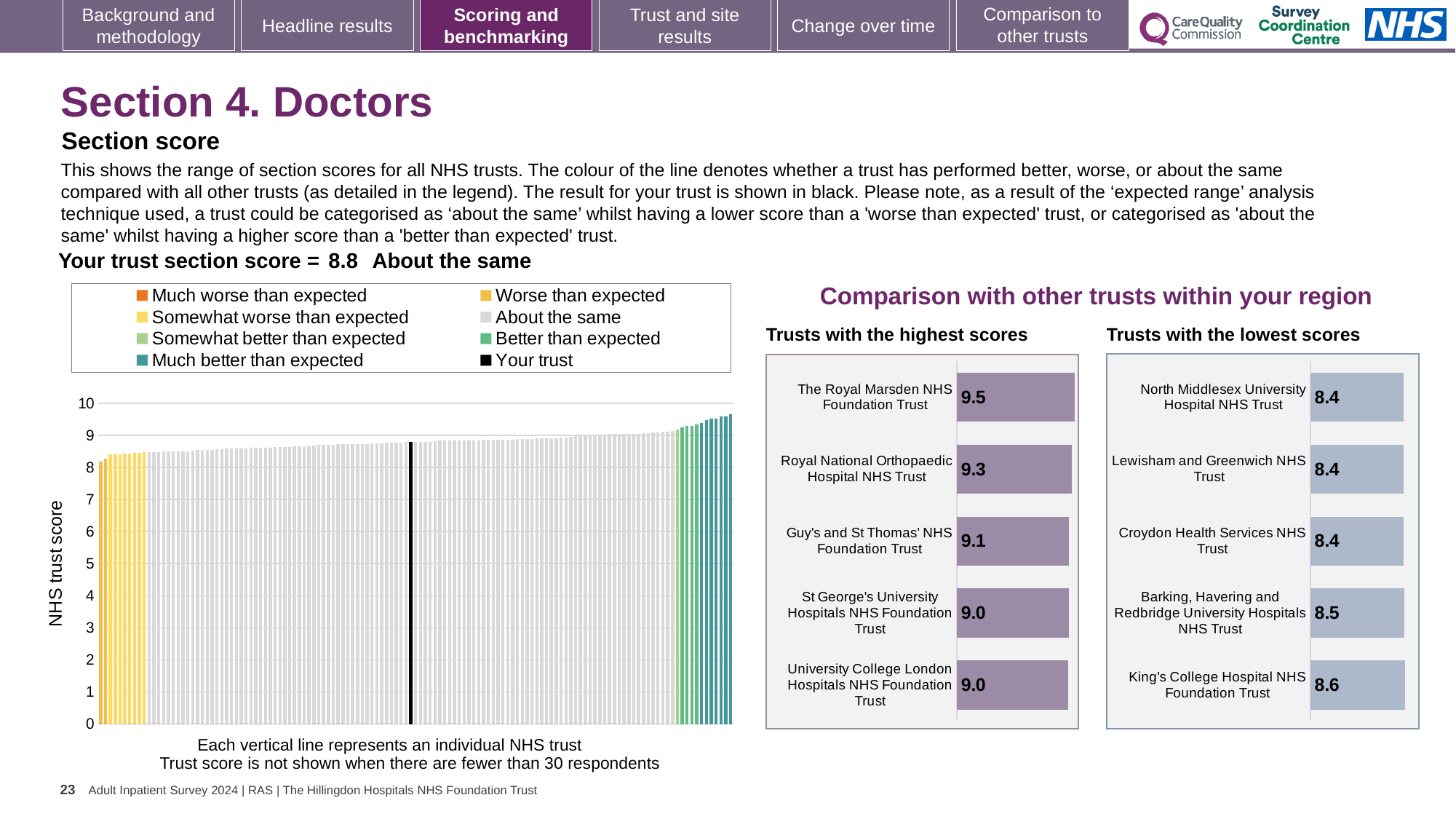
What kind of chart is the large 'NHS trust score' chart on the left of the slide? Bar chart How many entries does the legend of the 'NHS trust score' chart on the left list? 8 In the 'Trusts with the lowest scores' chart, what is the score for Barking, Havering and Redbridge University Hospitals NHS Trust? 8.5 In the 'Trusts with the highest scores' chart, what is the difference between the scores of The Royal Marsden NHS Foundation Trust and University College London Hospitals NHS Foundation Trust? 0.5 Which is larger: the score for Royal National Orthopaedic Hospital NHS Trust in the highest scores chart, or the score for North Middlesex University Hospital NHS Trust in the lowest scores chart? Royal National Orthopaedic Hospital NHS Trust In the 'Trusts with the lowest scores' chart, what is the score for King's College Hospital NHS Foundation Trust? 8.6 How many trusts are listed in the 'Trusts with the highest scores' chart? 5 In the 'Trusts with the highest scores' chart, what is the score for The Royal Marsden NHS Foundation Trust? 9.5 In the 'Trusts with the lowest scores' chart, what is the difference between the scores of King's College Hospital NHS Foundation Trust and Croydon Health Services NHS Trust? 0.2 In the 'Trusts with the highest scores' chart, which trust has the highest score? The Royal Marsden NHS Foundation Trust In the 'Trusts with the lowest scores' chart, which trust has the highest score shown? King's College Hospital NHS Foundation Trust In the 'Trusts with the highest scores' chart, what is the score for Guy's and St Thomas' NHS Foundation Trust? 9.1